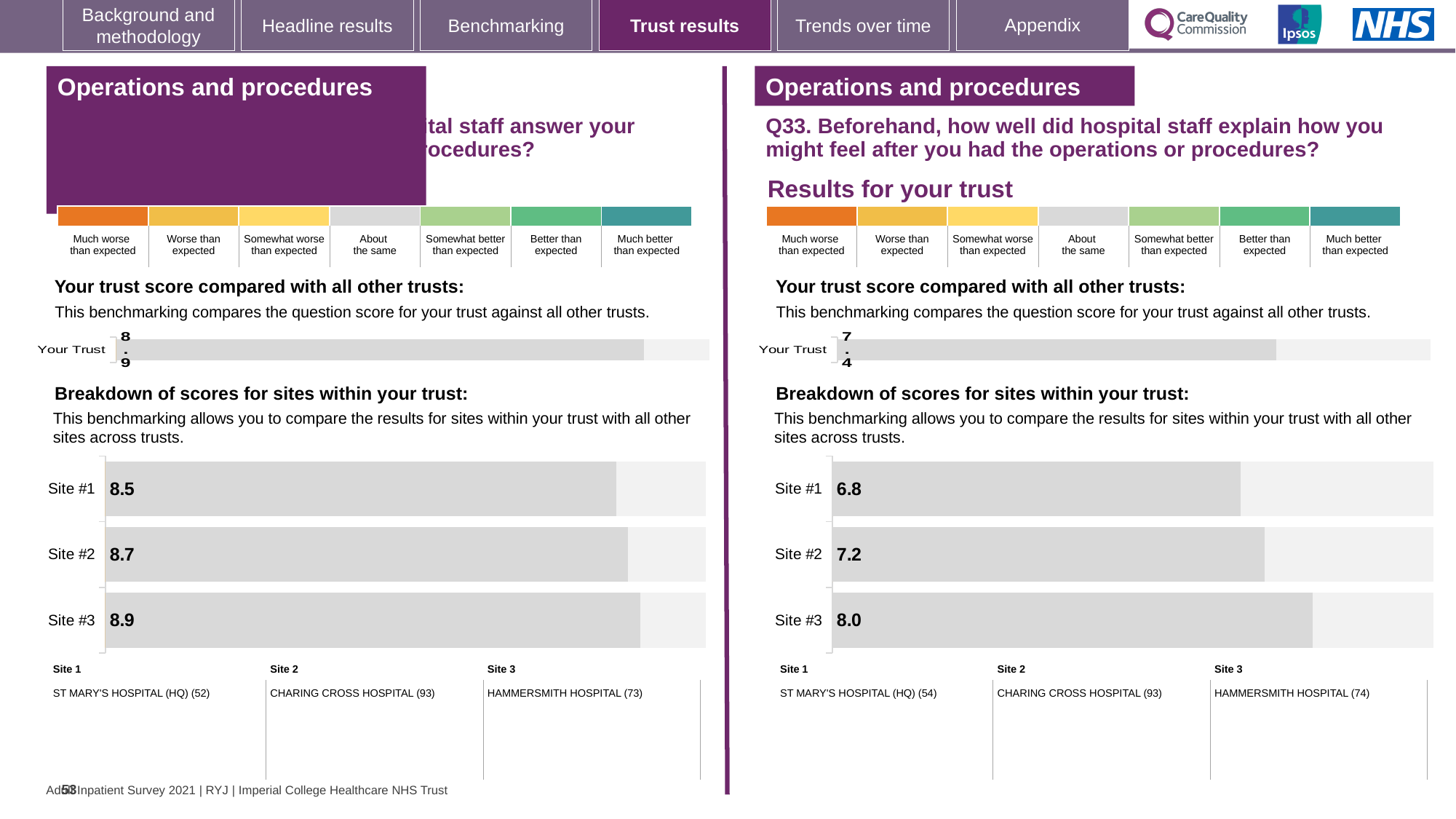
On the left-hand 'Breakdown of scores for sites within your trust' chart, what is the score for Site #1? 8.5 What is the 'Your Trust' score shown on the Q33 'Your trust score compared with all other trusts' chart? 7.4 On the left-hand 'Breakdown of scores for sites within your trust' chart, what is the score for Site #3? 8.9 On the left-hand 'Breakdown of scores for sites within your trust' chart, what is the difference between the scores for Site #2 and Site #1? 0.2 On the Q33 'Breakdown of scores for sites within your trust' chart, which site has the lowest score? Site #1 On the Q33 'Breakdown of scores for sites within your trust' chart, what is the difference between the scores for Site #3 and Site #1? 1.2 On the left-hand 'Breakdown of scores for sites within your trust' chart, which site has the highest score? Site #3 On the Q33 'Breakdown of scores for sites within your trust' chart, which is larger: the score for Site #2 or Site #3? Site #3 What kind of chart is the Q33 'Breakdown of scores for sites within your trust' chart? Bar chart What is the 'Your Trust' score shown on the left-hand 'Your trust score compared with all other trusts' chart? 8.9 On the Q33 'Breakdown of scores for sites within your trust' chart, what is the score for Site #2? 7.2 How many sites are shown on the Q33 'Breakdown of scores for sites within your trust' chart? 3